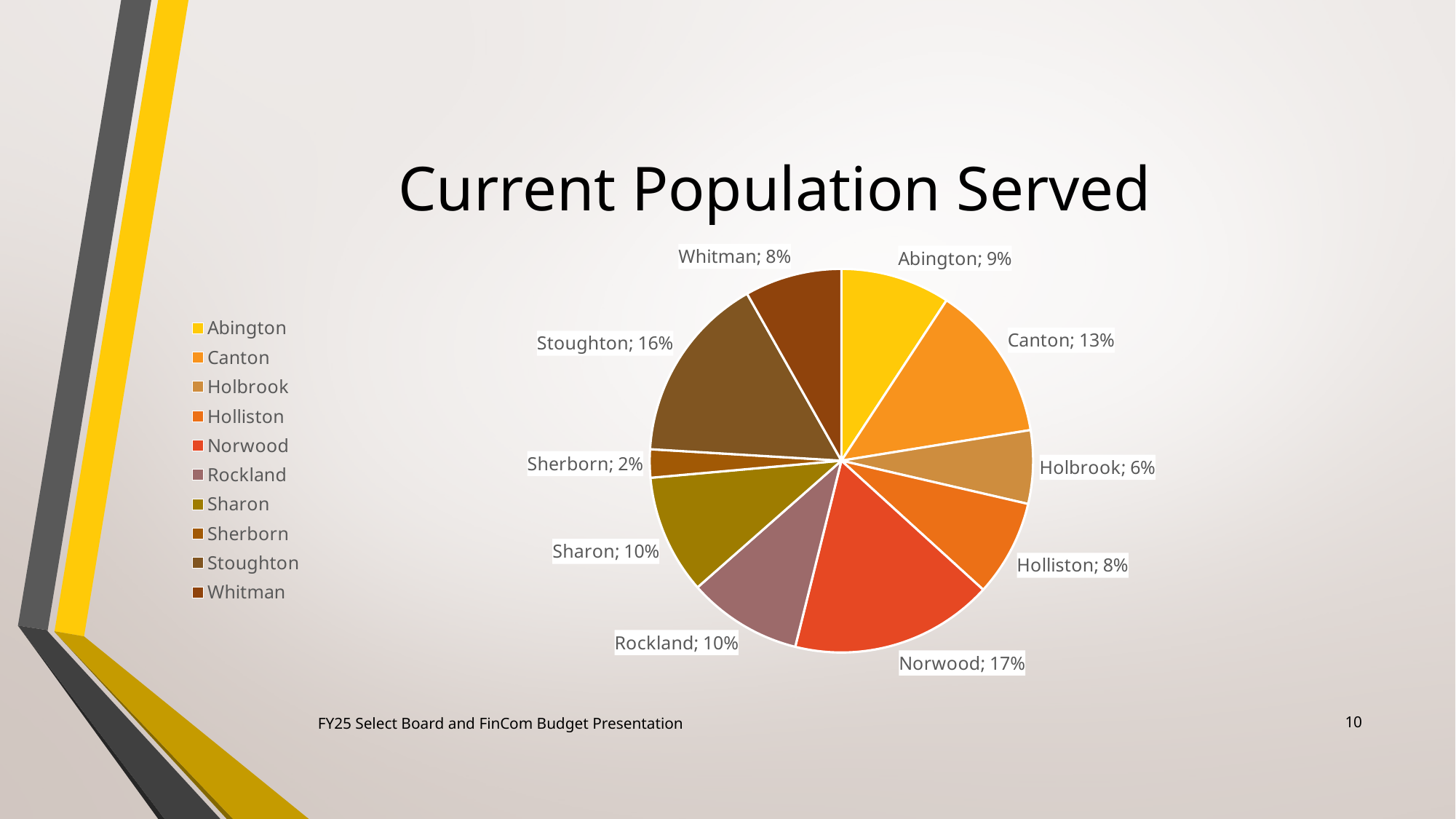
How many towns are shown in the pie chart? 10 What percentage is shown for Sherborn? 2% Which is larger, the share for Abington or the share for Holliston? Abington Which town has the smallest slice of the pie? Sherborn What kind of chart is shown on the slide? pie chart What is the difference in percentage points between Canton and Holbrook? 7 What percentage is shown for Stoughton? 16% What is the combined percentage of Sharon and Rockland? 20% What share of the pie does Norwood represent? 17% Which town has the largest slice of the pie? Norwood How many entries does the legend list? 10 What is the title of the chart? Current Population Served